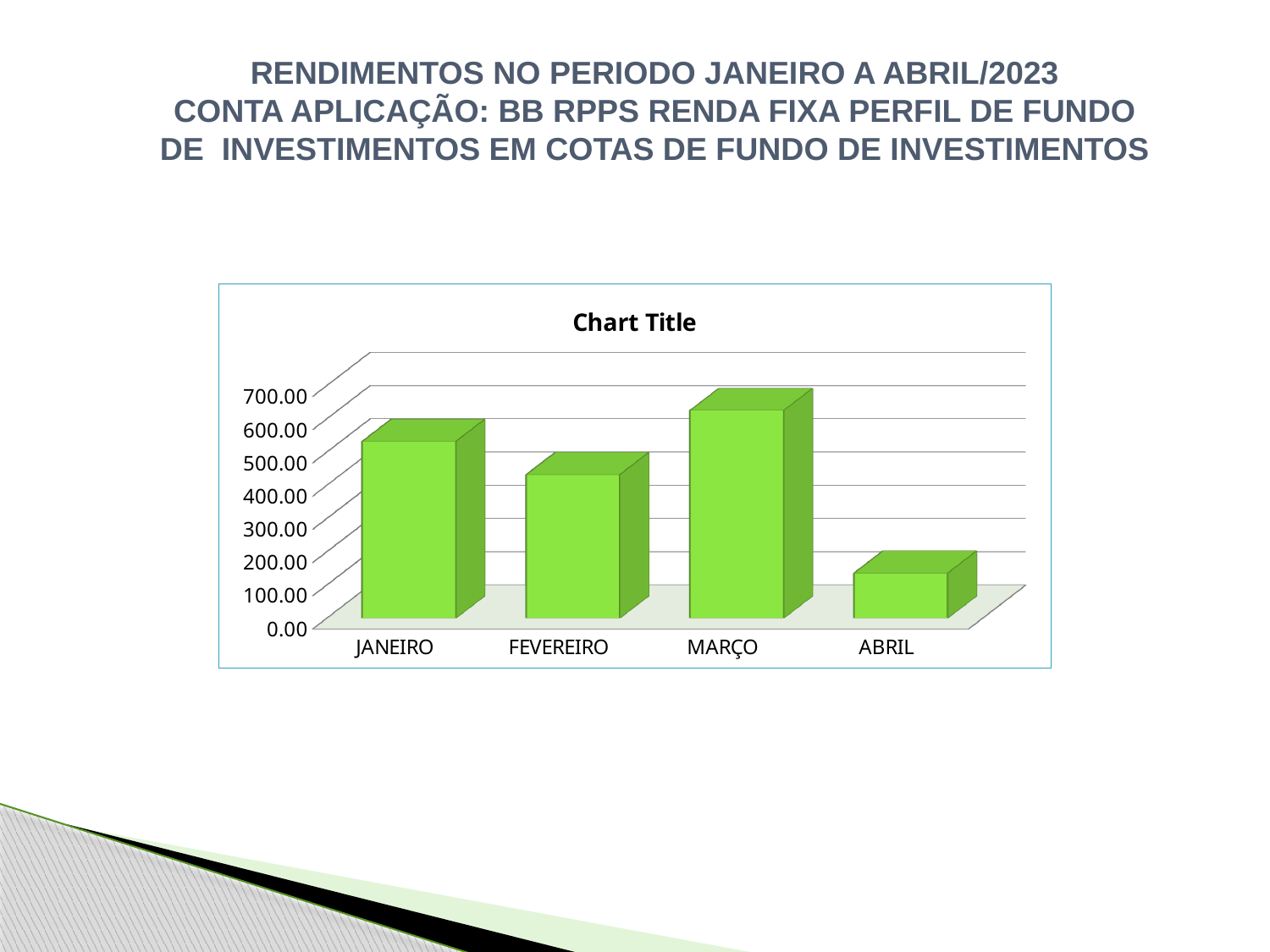
Is the value for JANEIRO greater or less than 400.00? greater Which month has the highest bar in the chart? MARÇO Is the value for FEVEREIRO greater or less than 600.00? less Does the value rise or fall from MARÇO to ABRIL? fall What title is printed above the plot area of the chart? Chart Title Is the value for ABRIL greater or less than 300.00? less Which is larger, the value for MARÇO or the value for ABRIL? MARÇO What kind of chart is shown on the slide? bar chart Which month has the lowest bar in the chart? ABRIL Which is larger, the value for JANEIRO or the value for FEVEREIRO? JANEIRO How many categories are plotted on the x axis of the chart? 4